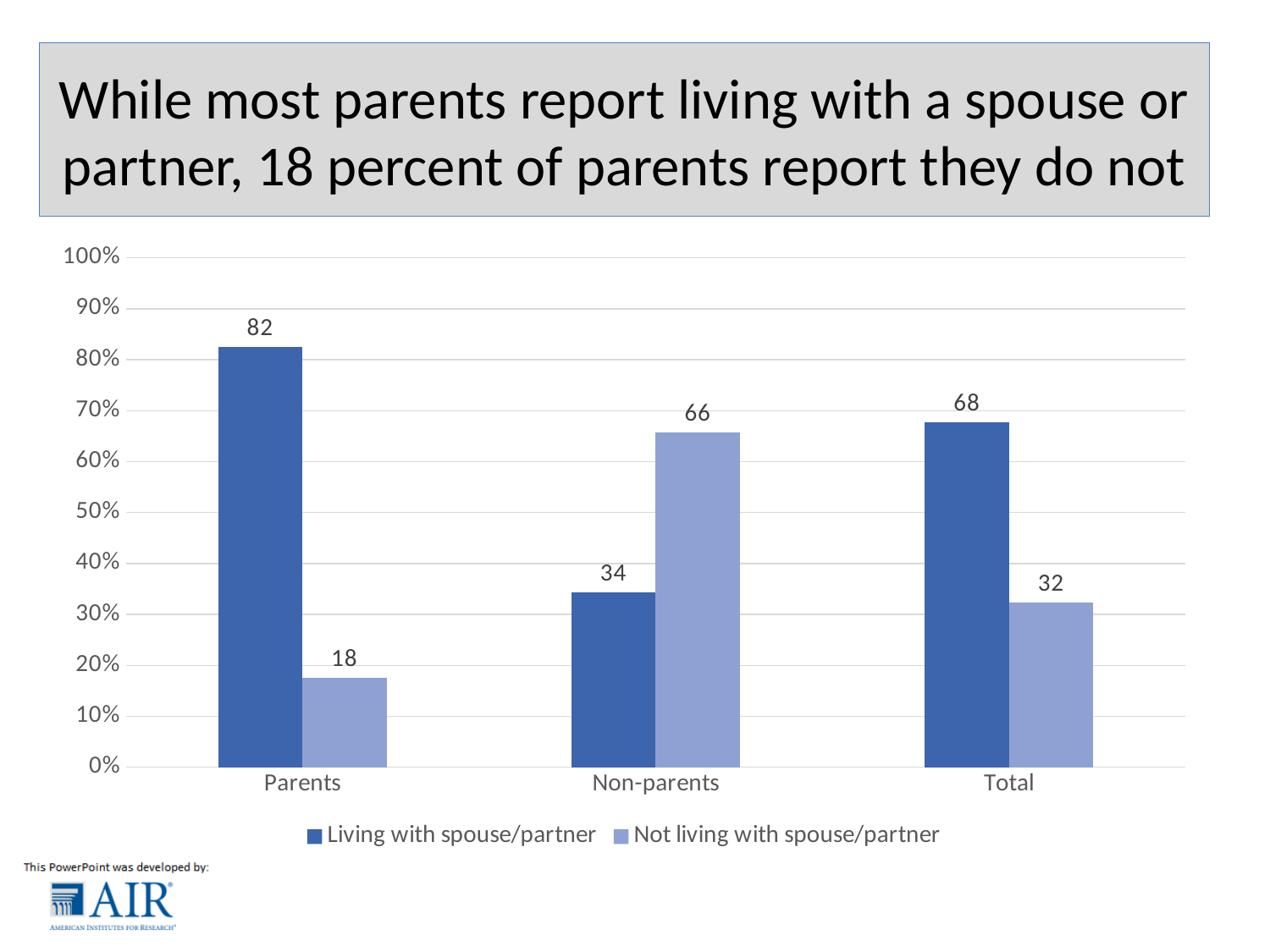
For Non-parents, which is larger: Living with spouse/partner or Not living with spouse/partner? Not living with spouse/partner Which category has the highest value in the Living with spouse/partner series? Parents What is the value for Parents in the Not living with spouse/partner series? 18 What is the value for Non-parents in the Not living with spouse/partner series? 66 Which category has the lowest value in the Not living with spouse/partner series? Parents What is the value for Total in the Living with spouse/partner series? 68 What kind of chart is shown on the slide? Bar chart Is the value for Total in the Not living with spouse/partner series greater or less than 40%? less How many categories are shown on the x axis? 3 How many series does the legend list? 2 What is the value for Parents in the Living with spouse/partner series? 82 What is the difference between the Living with spouse/partner and Not living with spouse/partner values for Parents? 64